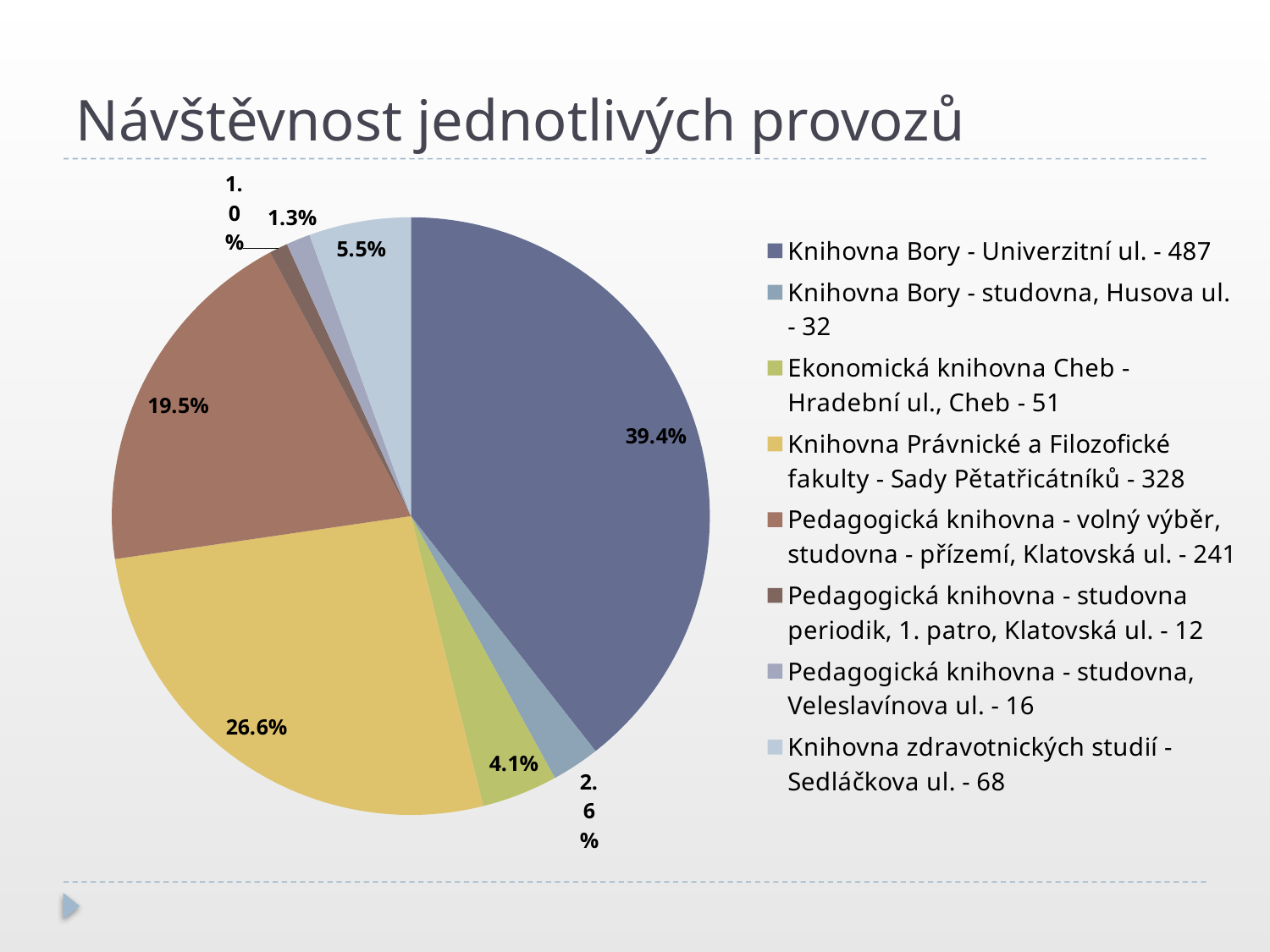
Which is larger: the slice for Pedagogická knihovna - volný výběr, studovna - přízemí, Klatovská ul. or the slice for Knihovna zdravotnických studií - Sedláčkova ul.? Pedagogická knihovna - volný výběr, studovna - přízemí, Klatovská ul. What share of the pie does Knihovna zdravotnických studií - Sedláčkova ul. have? 5.5% What is the difference in percentage points between the Knihovna Bory - Univerzitní ul. slice and the Knihovna Právnické a Filozofické fakulty slice? 12.8 What kind of chart is shown on the slide? pie chart What is the title of the chart? Návštěvnost jednotlivých provozů Which slice is the largest in the pie chart? Knihovna Bory - Univerzitní ul. - 487 What share of the pie does Pedagogická knihovna - volný výběr, studovna - přízemí, Klatovská ul. have? 19.5% What share of the pie does Ekonomická knihovna Cheb - Hradební ul., Cheb have? 4.1% How many slices does the pie chart have? 8 Which slice is the smallest in the pie chart? Pedagogická knihovna - studovna periodik, 1. patro, Klatovská ul. - 12